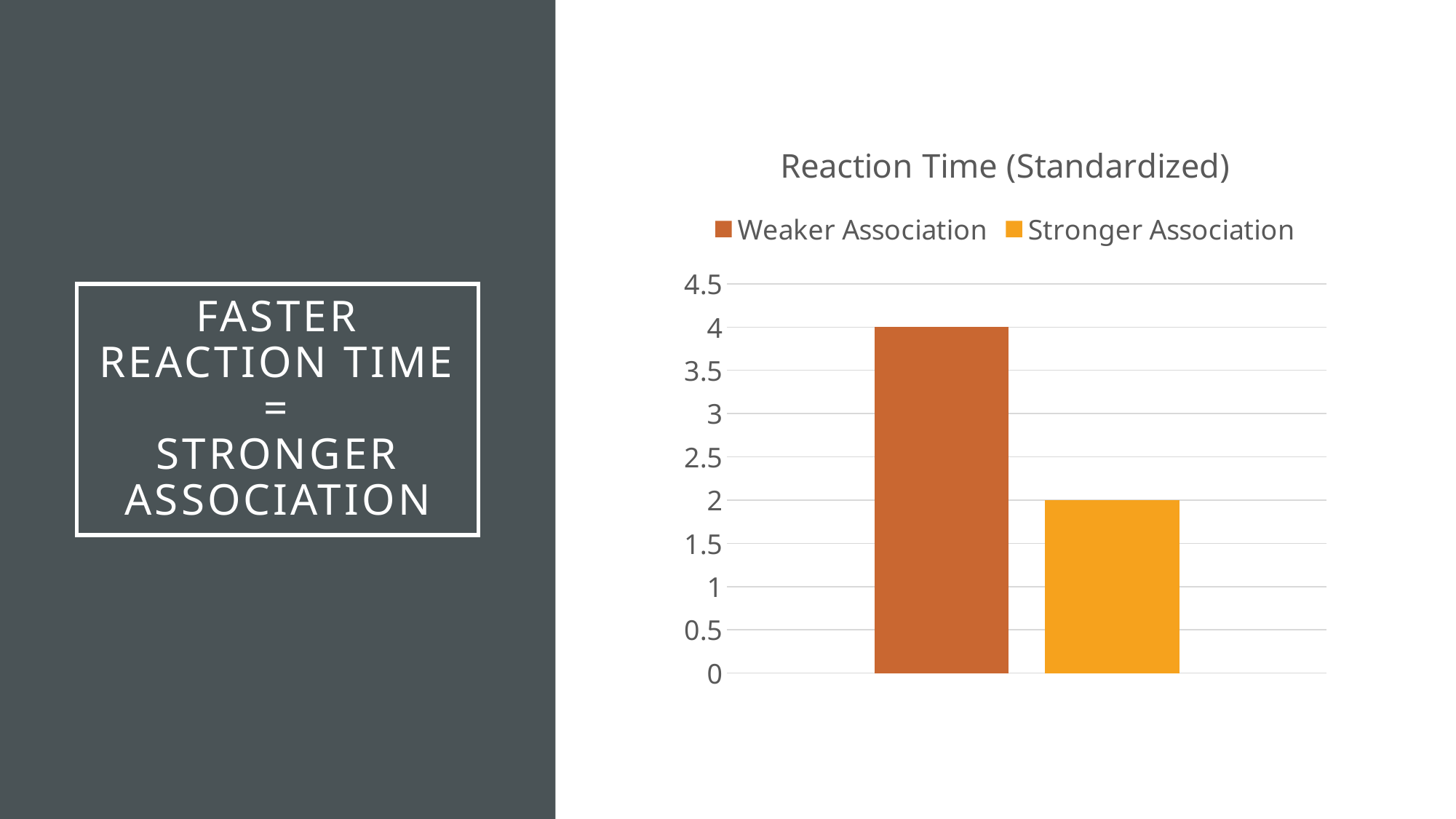
What is the title of the chart on the slide? Reaction Time (Standardized) Is the value for Stronger Association greater or less than 2.5? less Is the value for Weaker Association greater or less than 3? greater Which series has the higher value in the Reaction Time (Standardized) chart? Weaker Association How many series does the legend list in the Reaction Time (Standardized) chart? 2 Which series has the lower value in the Reaction Time (Standardized) chart? Stronger Association What is the value for Weaker Association in the Reaction Time (Standardized) chart? 4 What is the value for Stronger Association in the Reaction Time (Standardized) chart? 2 What is the difference between the Weaker Association and Stronger Association values? 2 Is the value for Weaker Association larger or smaller than the value for Stronger Association? larger How many bars are plotted in the Reaction Time (Standardized) chart? 2 What kind of chart is shown on the slide? Bar chart